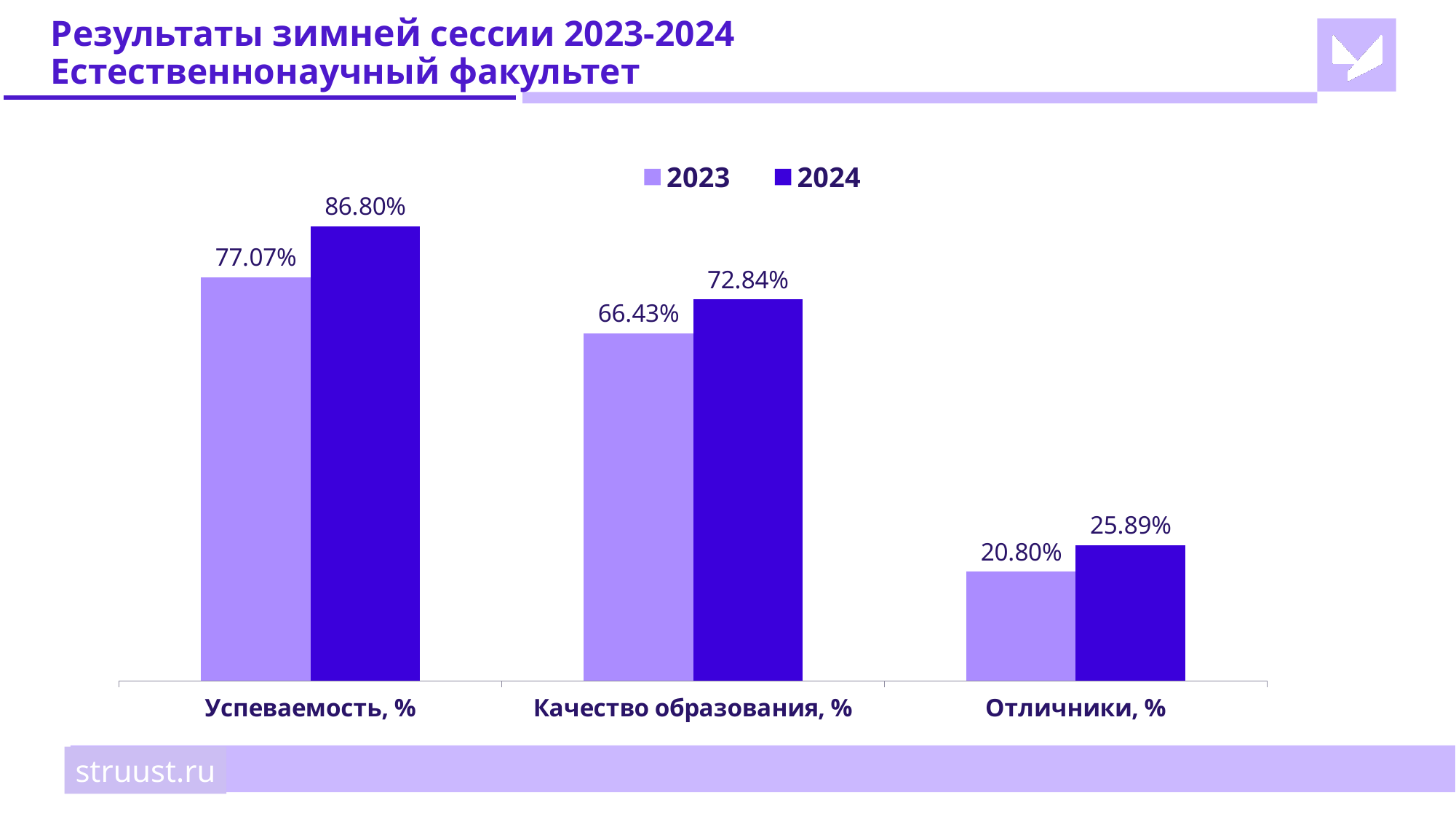
Which category has the lowest value for the 2023 series? Отличники, % What is the value for 2023 in the Отличники, % category? 20.80% Which category has the highest value for the 2024 series? Успеваемость, % Which series is shown in the darker purple colour? 2024 What kind of chart is shown on the slide? Bar chart What is the value for 2023 in the Качество образования, % category? 66.43% In the Качество образования, % category, which series has the larger value, 2023 or 2024? 2024 What is the value for 2024 in the Успеваемость, % category? 86.80% How many categories are shown on the x axis? 3 What is the difference between the 2024 and 2023 values in the Успеваемость, % category? 9.73% How many series does the legend list? 2 What is the difference between the 2024 and 2023 values in the Отличники, % category? 5.09%